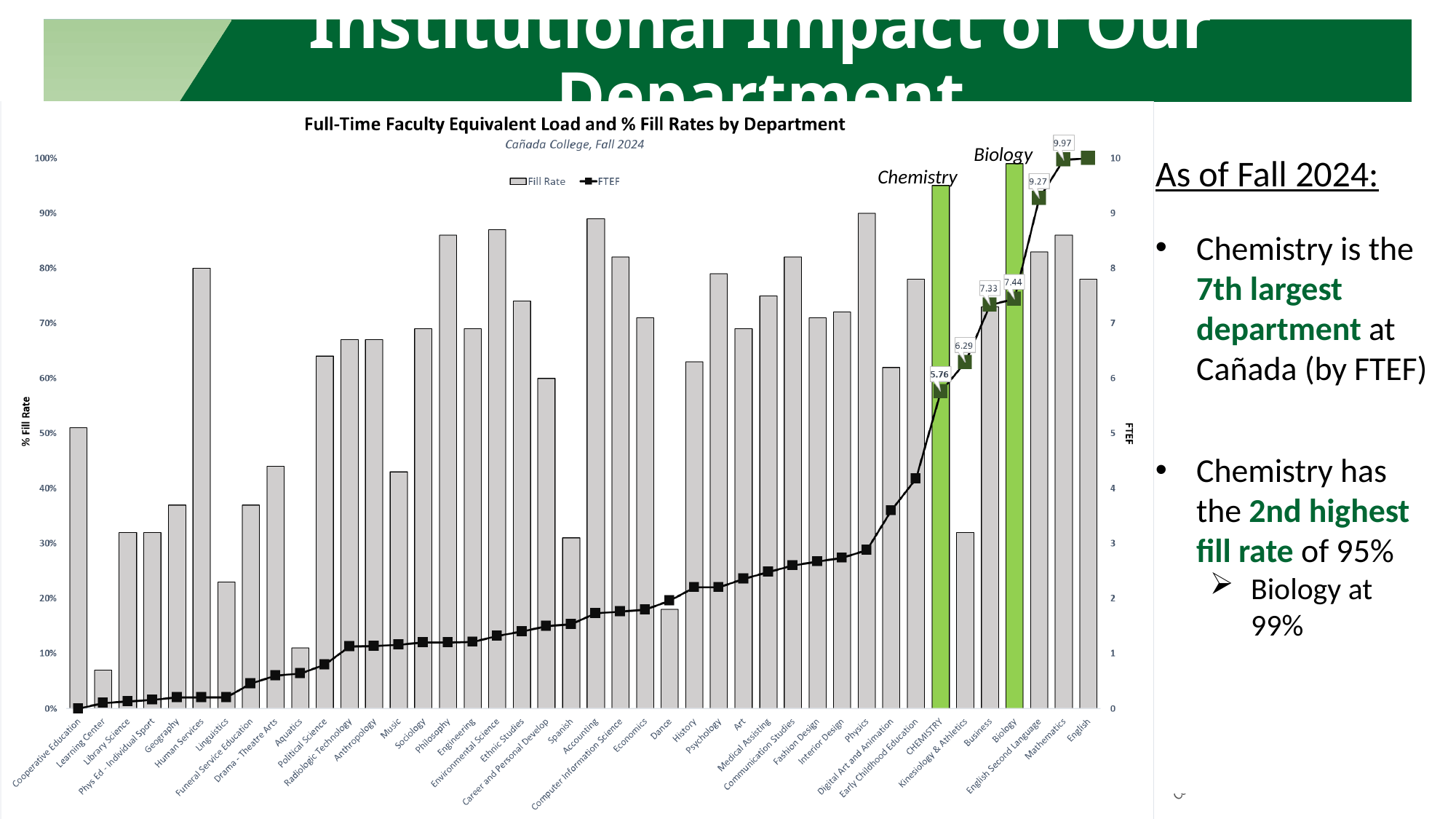
What is the FTEF value for Chemistry? 5.76 What kind of chart is this? Bar and line chart Which department has the lowest FTEF? Cooperative Education What is the difference in FTEF between Biology and Chemistry? 1.68 Which two departments are highlighted with green bars? Chemistry and Biology Does the FTEF line rise or fall from left to right along the x axis? Rises What is the FTEF value for Biology? 7.44 What is the FTEF value for Mathematics? 9.97 How many series does the legend list? 2 Which has the higher FTEF, Business or Kinesiology & Athletics? Business Is the fill rate for Dance greater or less than 30%? less What is the FTEF value for English Second Language? 9.27